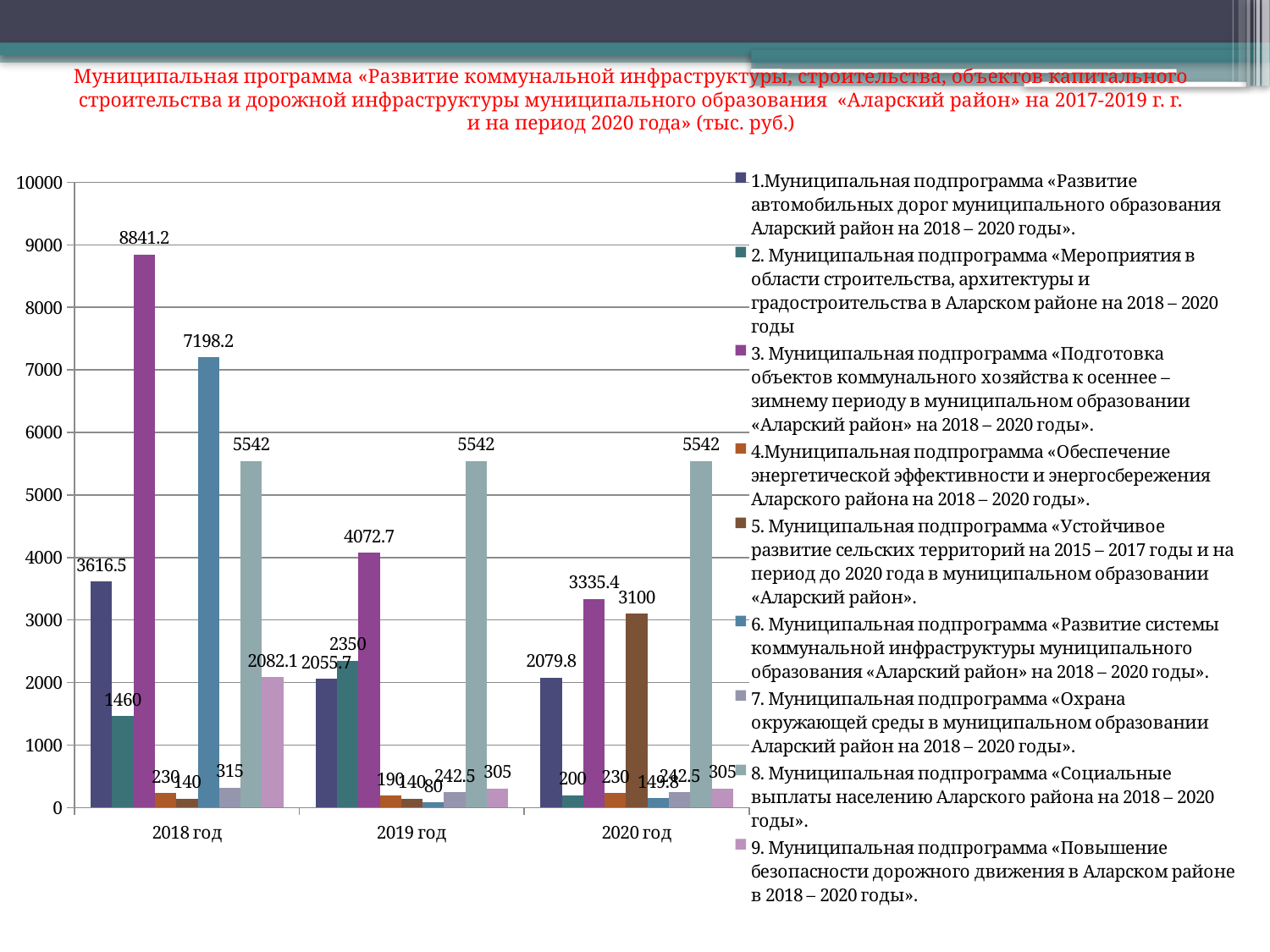
What is the value for subprogram 6 («Развитие системы коммунальной инфраструктуры...») in 2018 год? 7198.2 What is the value for subprogram 8 («Социальные выплаты населению...») in 2019 год? 5542 How many series does the legend list? 9 How many year categories are shown on the x axis? 3 What is the difference between the values for subprogram 3 in 2018 год and 2019 год? 4768.5 Which subprogram has the highest value in 2018 год? 3. Муниципальная подпрограмма «Подготовка объектов коммунального хозяйства к осеннее – зимнему периоду...» What kind of chart is shown on the slide? bar chart In 2020 год, which is larger: the value for subprogram 3 (3335.4) or subprogram 5 (3100)? subprogram 3 (3335.4) Does the value for subprogram 3 rise or fall from 2018 год to 2020 год? fall What is the value for subprogram 5 («Устойчивое развитие сельских территорий...») in 2020 год? 3100 What is the value for subprogram 3 («Подготовка объектов коммунального хозяйства...») in 2018 год? 8841.2 Is the value for subprogram 1 («Развитие автомобильных дорог...») in 2018 год greater or less than 3000? greater